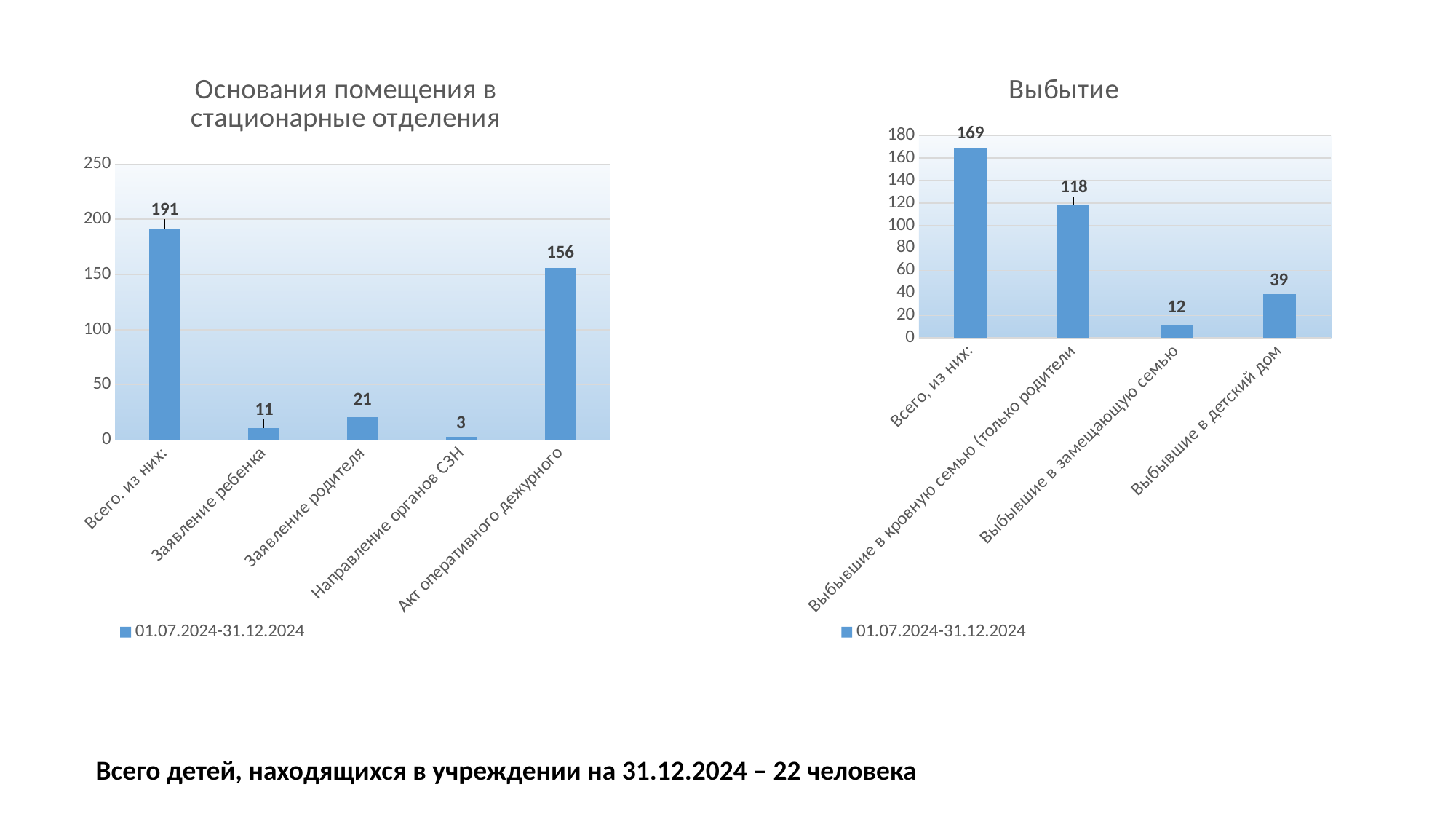
In the chart 'Выбытие', which category has the highest value? Всего, из них: In the chart 'Выбытие', how many series does the legend list? 1 In the chart 'Основания помещения в стационарные отделения', how many categories are shown on the x axis? 5 In the chart 'Основания помещения в стационарные отделения', what is the value for 'Акт оперативного дежурного'? 156 In the chart 'Выбытие', what is the value for 'Выбывшие в детский дом'? 39 In the chart 'Основания помещения в стационарные отделения', which is larger: 'Заявление ребенка' or 'Заявление родителя'? Заявление родителя In the chart 'Выбытие', what is the difference between 'Всего, из них:' and 'Выбывшие в кровную семью (только родители'? 51 What type of chart is the chart titled 'Выбытие'? Bar chart In the chart 'Основания помещения в стационарные отделения', what is the difference between 'Всего, из них:' and 'Акт оперативного дежурного'? 35 In the chart 'Основания помещения в стационарные отделения', what is the value for 'Заявление родителя'? 21 In the chart 'Выбытие', what is the value for 'Выбывшие в замещающую семью'? 12 In the chart 'Основания помещения в стационарные отделения', which category has the lowest value? Направление органов СЗН